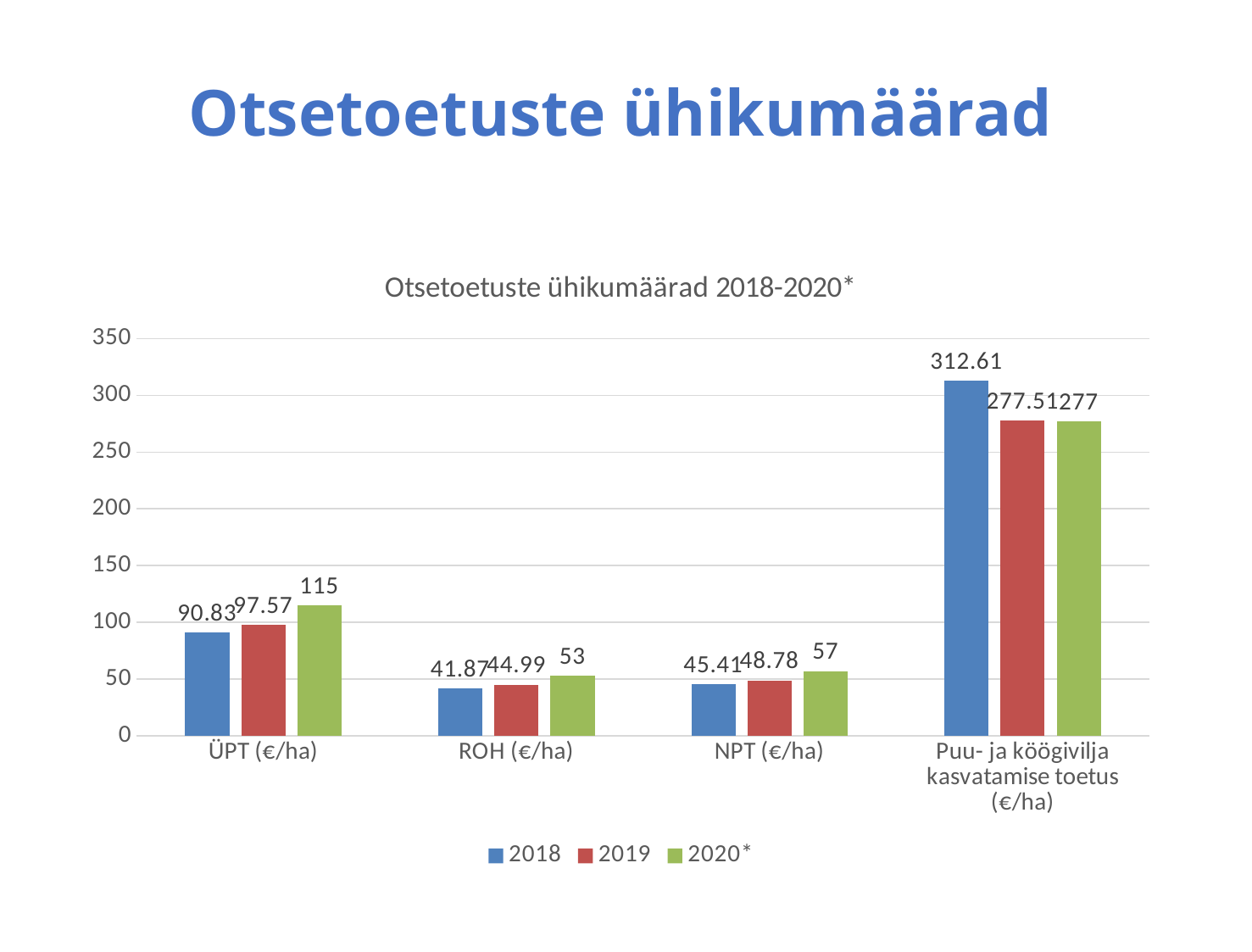
How many series does the legend list? 3 What is the 2019 value for NPT (€/ha)? 48.78 How many categories are shown on the x axis? 4 What is the 2018 value for ÜPT (€/ha)? 90.83 What is the 2018 value for Puu- ja köögivilja kasvatamise toetus (€/ha)? 312.61 What kind of chart is shown on the slide? Bar chart What is the title of the chart? Otsetoetuste ühikumäärad 2018-2020* Which category has the highest 2020* value? Puu- ja köögivilja kasvatamise toetus (€/ha) Which is larger for Puu- ja köögivilja kasvatamise toetus (€/ha): the 2018 value or the 2019 value? 2018 Which category has the lowest 2018 value? ROH (€/ha) What is the 2020* value for ROH (€/ha)? 53 What is the difference between the 2020* and 2018 values for ÜPT (€/ha)? 24.17